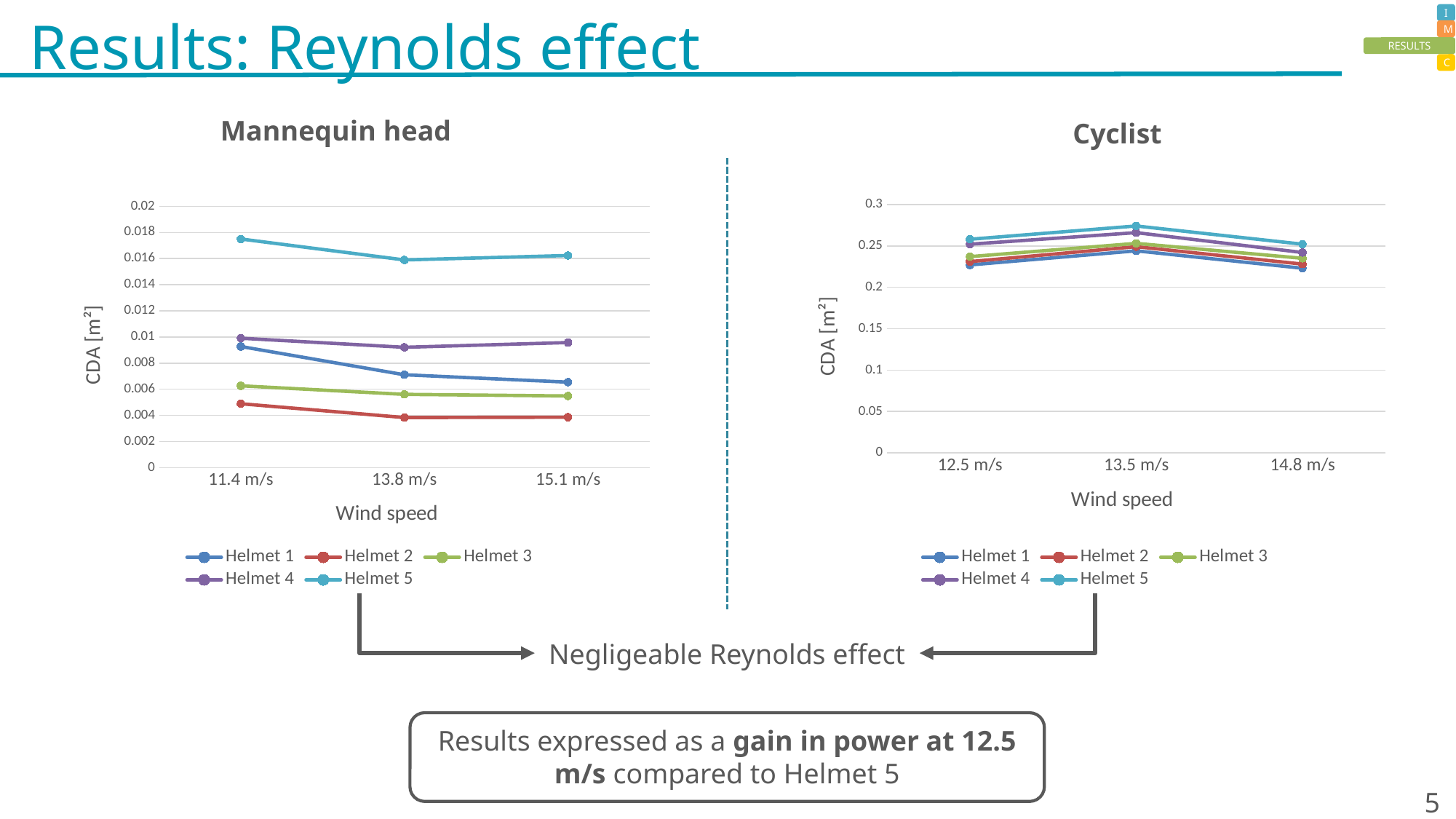
In the Cyclist chart, is the value for Helmet 5 at 13.5 m/s greater or less than 0.25? greater In the Mannequin head chart, which is larger at 11.4 m/s: Helmet 4 or Helmet 3? Helmet 4 In the Cyclist chart, is the value for Helmet 1 at 12.5 m/s greater or less than 0.25? less What kind of chart is the Mannequin head chart? Line chart What is the label of the x axis on the Cyclist chart? Wind speed In the Mannequin head chart, which helmet has the highest CDA at 11.4 m/s? Helmet 5 How many series does the legend of the Cyclist chart list? 5 In the Mannequin head chart, does the value for Helmet 1 rise or fall from 11.4 m/s to 13.8 m/s? fall In the Mannequin head chart, is the value for Helmet 1 at 11.4 m/s greater or less than 0.008? greater How many wind speed categories are shown on the x axis of the Mannequin head chart? 3 In the Mannequin head chart, which helmet has the lowest CDA at 15.1 m/s? Helmet 2